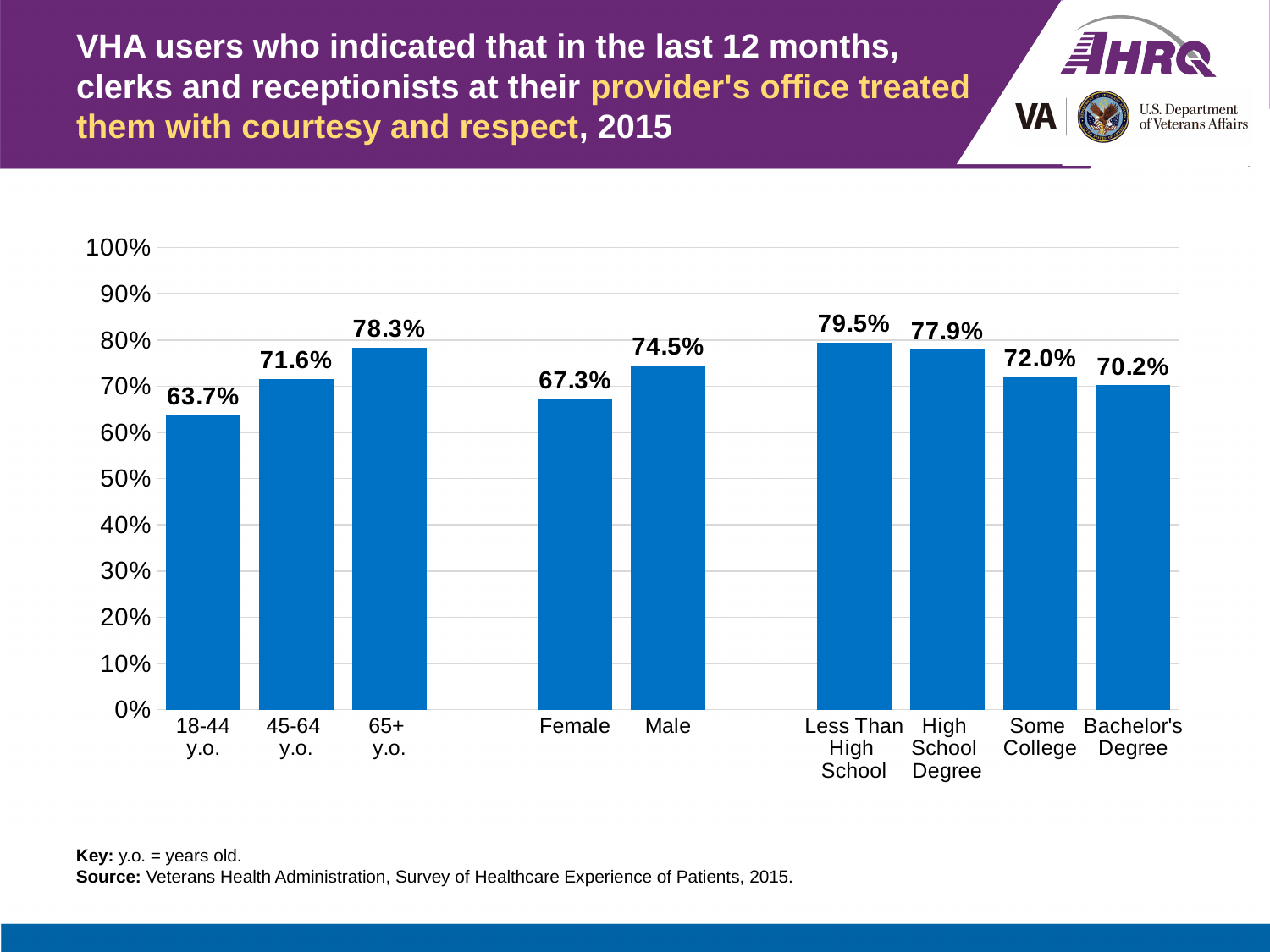
Is the value for 45-64 y.o. greater or less than 70%? greater Which category has the lowest value? 18-44 y.o. Which category has the highest value? Less Than High School What is the value for Bachelor's Degree? 70.2% How many categories are shown on the x axis? 9 What kind of chart is shown on the slide? Bar chart Do the values rise or fall across the three age groups from 18-44 y.o. to 65+ y.o.? Rise What is the difference between the values for 65+ y.o. and 18-44 y.o.? 14.6% What is the value for Female? 67.3% Which is larger, the value for High School Degree or the value for Some College? High School Degree What is the value for the 65+ y.o. group? 78.3% What is the difference between the values for Male and Female? 7.2%